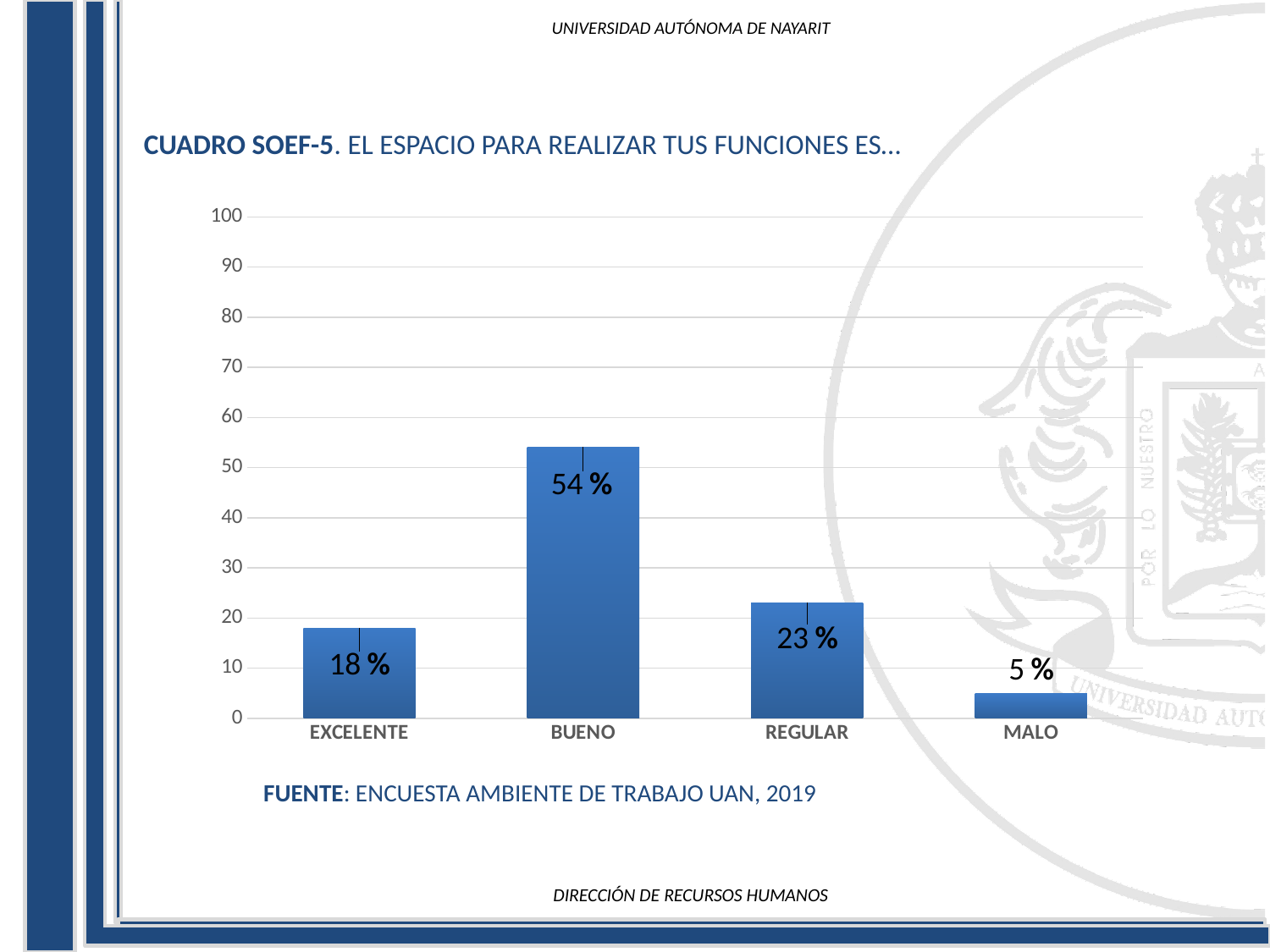
What is the value for REGULAR? 23 % Is the value for BUENO greater or less than 50? greater Which category has the lowest value? MALO What is the value for MALO? 5 % Which is larger, the value for EXCELENTE or the value for REGULAR? REGULAR What kind of chart is shown on the slide? bar chart How many categories are shown on the x axis? 4 What is the value for BUENO? 54 % What is the value for EXCELENTE? 18 % What is the difference between the values for BUENO and REGULAR? 31 % Which category has the highest value? BUENO What is the source cited below the chart? ENCUESTA AMBIENTE DE TRABAJO UAN, 2019